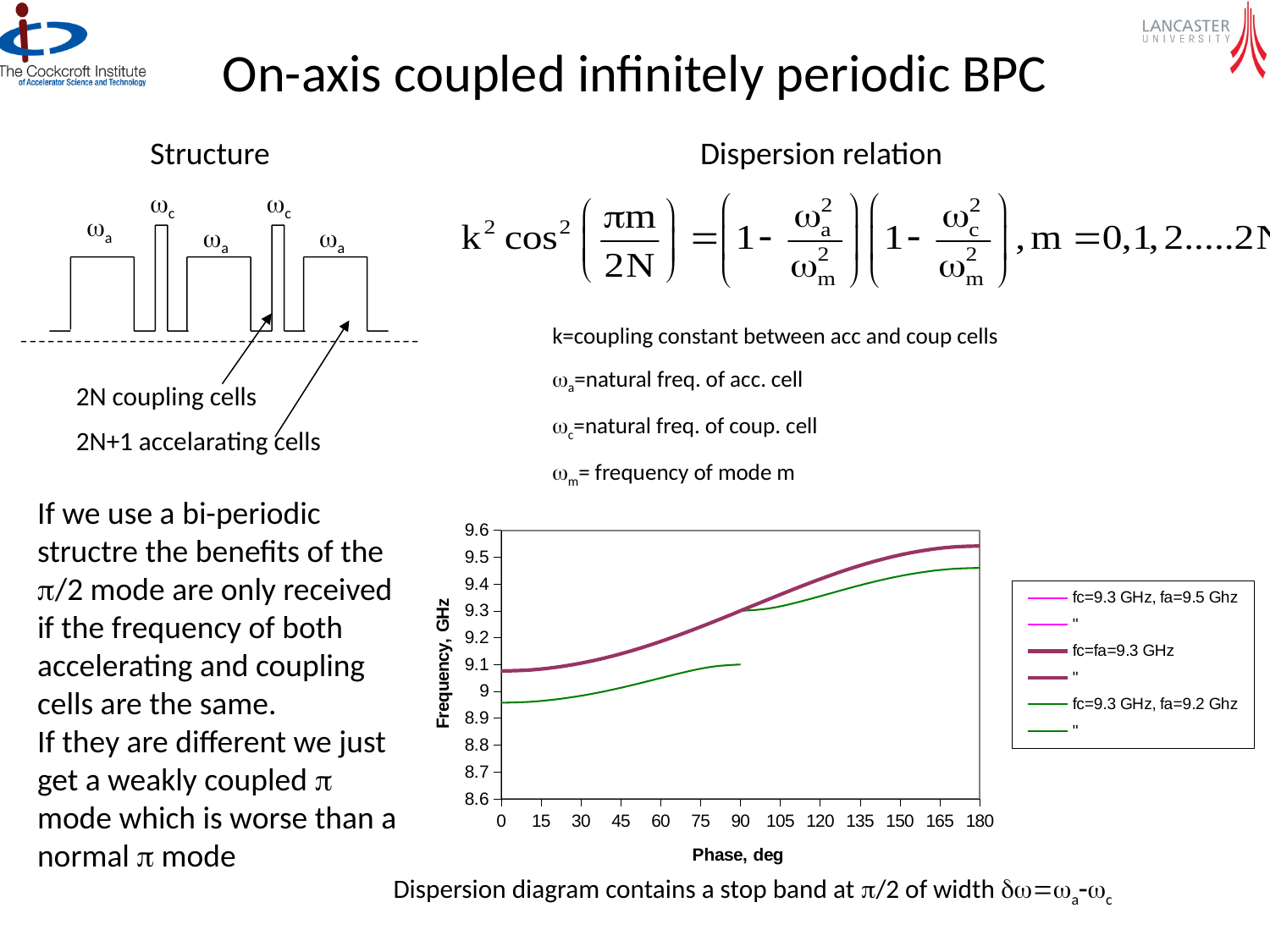
How many entries does the chart legend list? 6 How many tick labels are shown on the x axis of the chart? 13 Is the value of the fc=fa=9.3 GHz curve at 0 deg greater or less than 9.2 GHz? less What is the title of the y axis of the chart? Frequency, GHz At 180 deg, which curve is higher: fc=fa=9.3 GHz or fc=9.3 GHz, fa=9.2 Ghz? fc=fa=9.3 GHz Does the fc=fa=9.3 GHz curve rise or fall as phase increases from 0 to 180 deg? rise Is the value of the fc=fa=9.3 GHz curve at 90 deg greater or less than 9.2 GHz? greater What kind of chart is shown on the slide? line chart Is the value of the upper fc=9.3 GHz, fa=9.2 Ghz curve at 180 deg greater or less than 9.4 GHz? greater What is the title of the x axis of the chart? Phase, deg